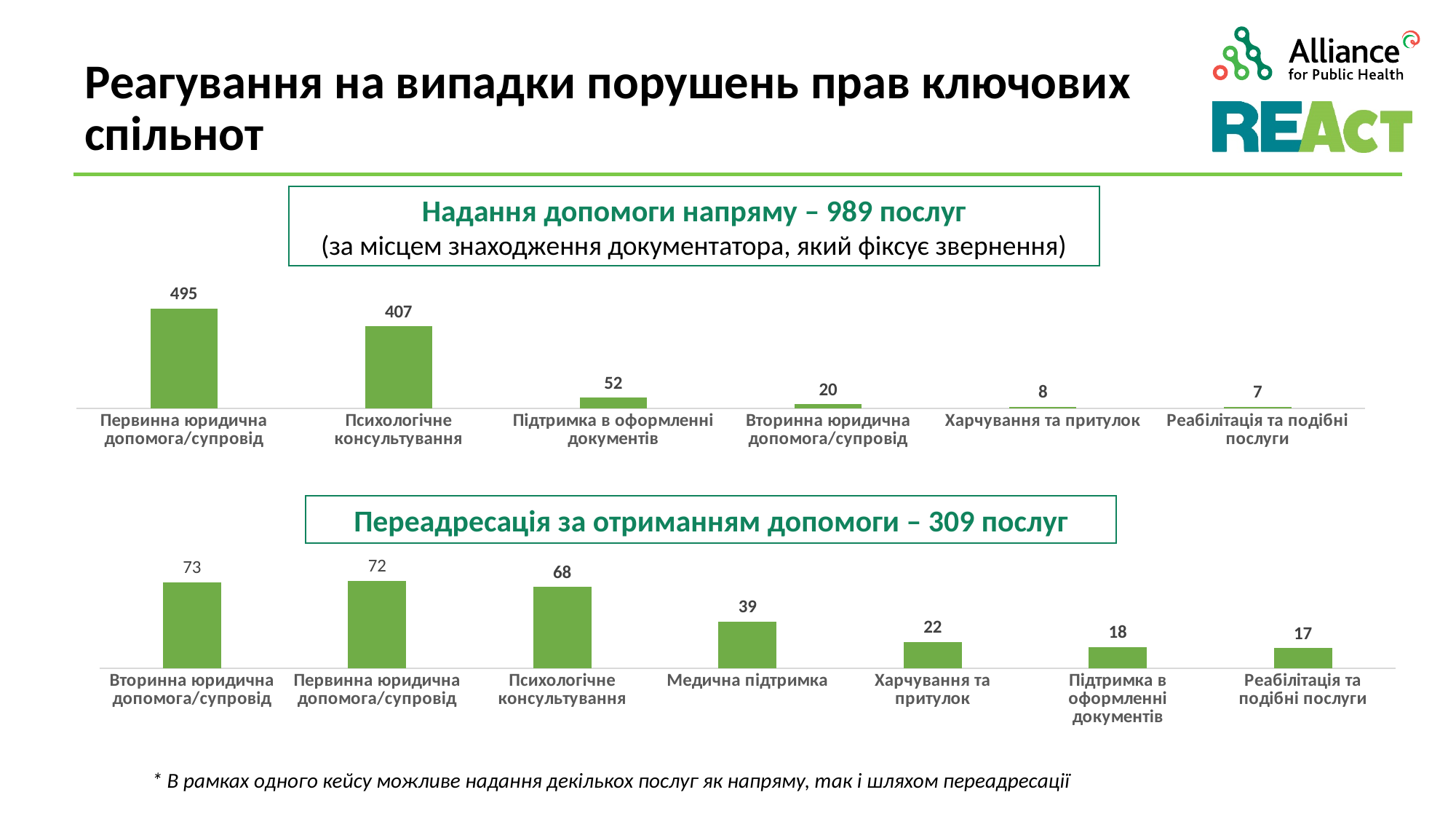
In the top chart (Надання допомоги напряму), what is the value for Підтримка в оформленні документів? 52 In the top chart (Надання допомоги напряму), what is the difference between Первинна юридична допомога/супровід and Психологічне консультування? 88 In the bottom chart (Переадресація за отриманням допомоги), what is the value for Медична підтримка? 39 In the bottom chart (Переадресація за отриманням допомоги), how many categories are shown? 7 In the bottom chart (Переадресація за отриманням допомоги), which is larger: Харчування та притулок or Підтримка в оформленні документів? Харчування та притулок In the bottom chart (Переадресація за отриманням допомоги), which category has the highest value? Вторинна юридична допомога/супровід In the top chart (Надання допомоги напряму), what is the value for Первинна юридична допомога/супровід? 495 In the bottom chart (Переадресація за отриманням допомоги), do the values rise or fall from left to right? Fall What type of chart is the bottom chart (Переадресація за отриманням допомоги)? Bar chart In the bottom chart (Переадресація за отриманням допомоги), what is the difference between Психологічне консультування and Реабілітація та подібні послуги? 51 In the top chart (Надання допомоги напряму), which category has the lowest value? Реабілітація та подібні послуги In the top chart (Надання допомоги напряму), how many categories are shown? 6